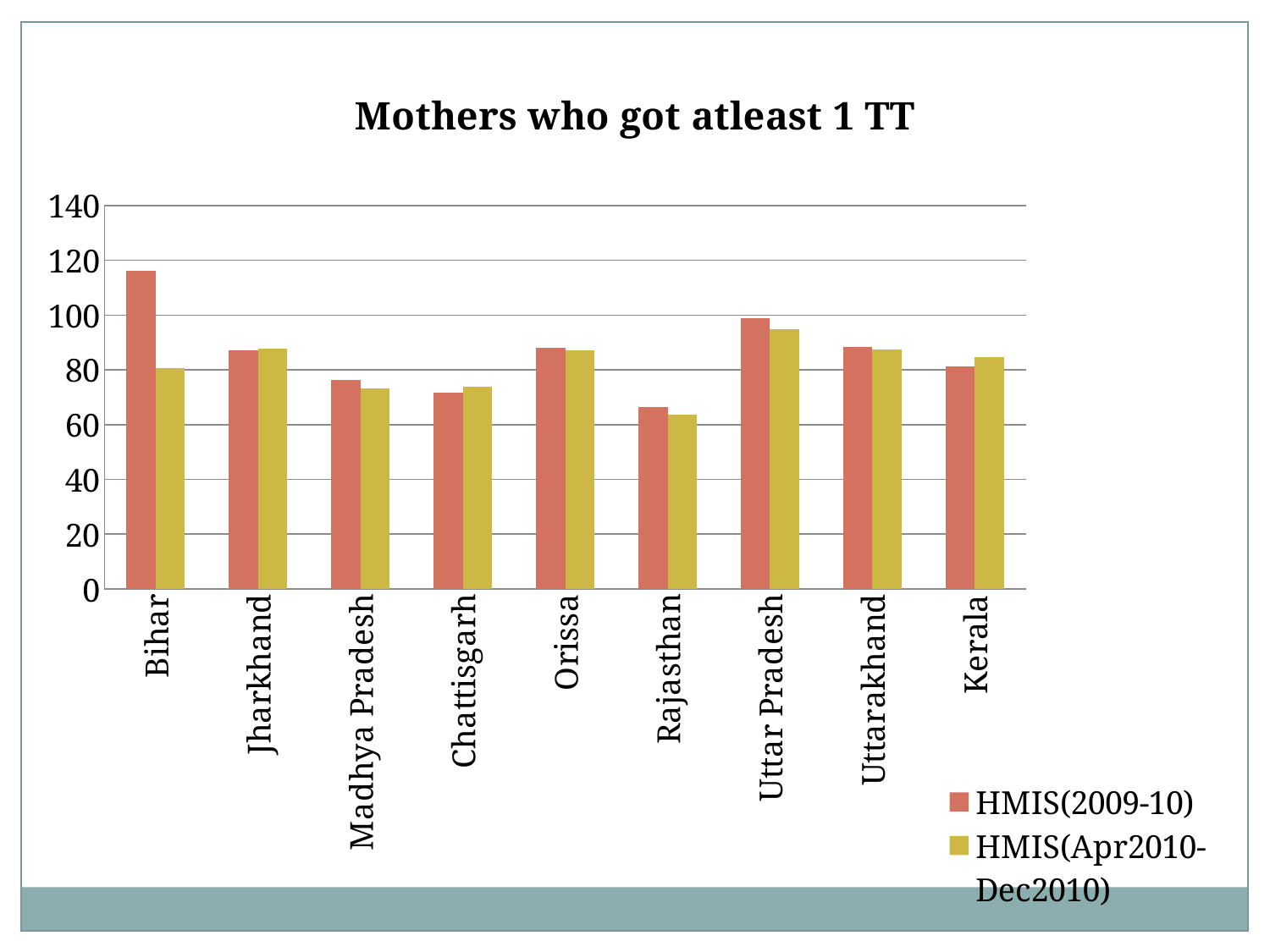
Which state has the highest value for HMIS(Apr2010-Dec2010)? Uttar Pradesh For HMIS(2009-10), which is larger, Bihar or Uttar Pradesh? Bihar Is the HMIS(2009-10) value for Bihar greater or less than 100? greater Is the HMIS(Apr2010-Dec2010) value for Rajasthan greater or less than 80? less Which state has the lowest value for HMIS(2009-10)? Rajasthan For Bihar, which series has the larger value, HMIS(2009-10) or HMIS(Apr2010-Dec2010)? HMIS(2009-10) What is the title of the chart? Mothers who got atleast 1 TT What kind of chart is shown on the slide? bar chart Which state has the highest value for HMIS(2009-10)? Bihar How many series does the legend list? 2 How many states are shown on the x axis? 9 Which state has the lowest value for HMIS(Apr2010-Dec2010)? Rajasthan